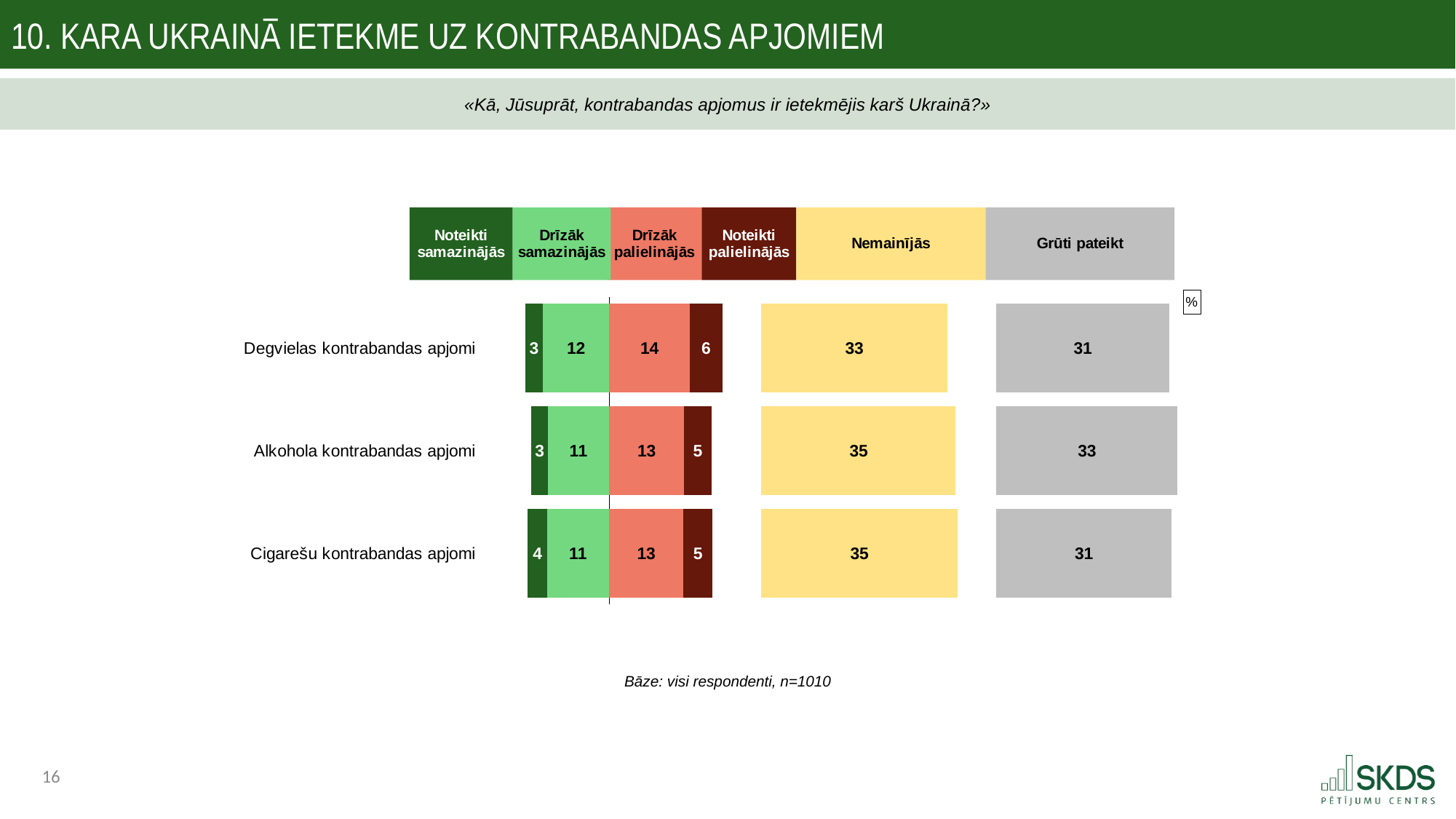
What is the value for "Drīzāk palielinājās" for "Degvielas kontrabandas apjomi"? 14 What kind of chart is shown on the slide? Stacked bar chart What is the value for "Nemainījās" for "Degvielas kontrabandas apjomi"? 33 Which is larger for "Drīzāk samazinājās": "Degvielas kontrabandas apjomi" or "Alkohola kontrabandas apjomi"? Degvielas kontrabandas apjomi How many categories are shown in the chart? 3 What is the value for "Grūti pateikt" for "Alkohola kontrabandas apjomi"? 33 What is the total of the stacked bar for "Alkohola kontrabandas apjomi"? 100 Which category has the lowest value for "Nemainījās"? Degvielas kontrabandas apjomi What is the value for "Noteikti samazinājās" for "Cigarešu kontrabandas apjomi"? 4 What is the difference between the "Grūti pateikt" values for "Alkohola kontrabandas apjomi" and "Degvielas kontrabandas apjomi"? 2 How many series does the legend list? 6 Which category has the highest value for "Noteikti palielinājās"? Degvielas kontrabandas apjomi